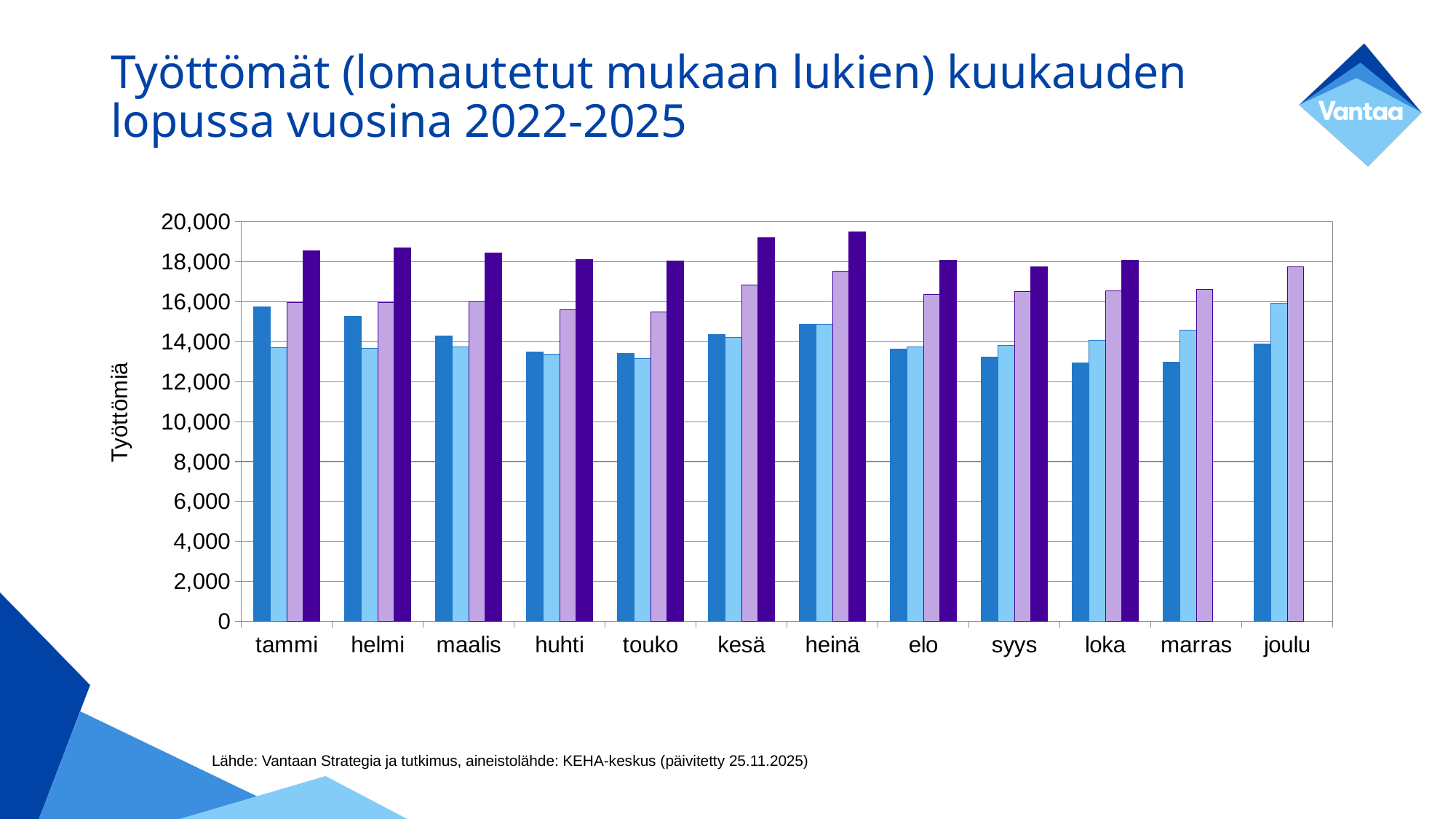
What kind of chart is shown on the slide? bar chart How many months are shown on the x axis of the chart? 12 What is the title of the chart on the slide? Työttömät (lomautetut mukaan lukien) kuukauden lopussa vuosina 2022-2025 Is the value of the dark blue bar for marras greater or less than 14,000? less Which is larger, the lavender bar for joulu or the lavender bar for marras? joulu In which month is the dark purple bar the highest? heinä How many bars are shown for joulu? 3 Is the value of the dark blue bar for tammi greater or less than 14,000? greater What is the label on the vertical axis of the chart? Työttömiä Is the value of the lavender bar for joulu greater or less than 16,000? greater Which is larger for kesä, the dark purple bar or the dark blue bar? the dark purple bar